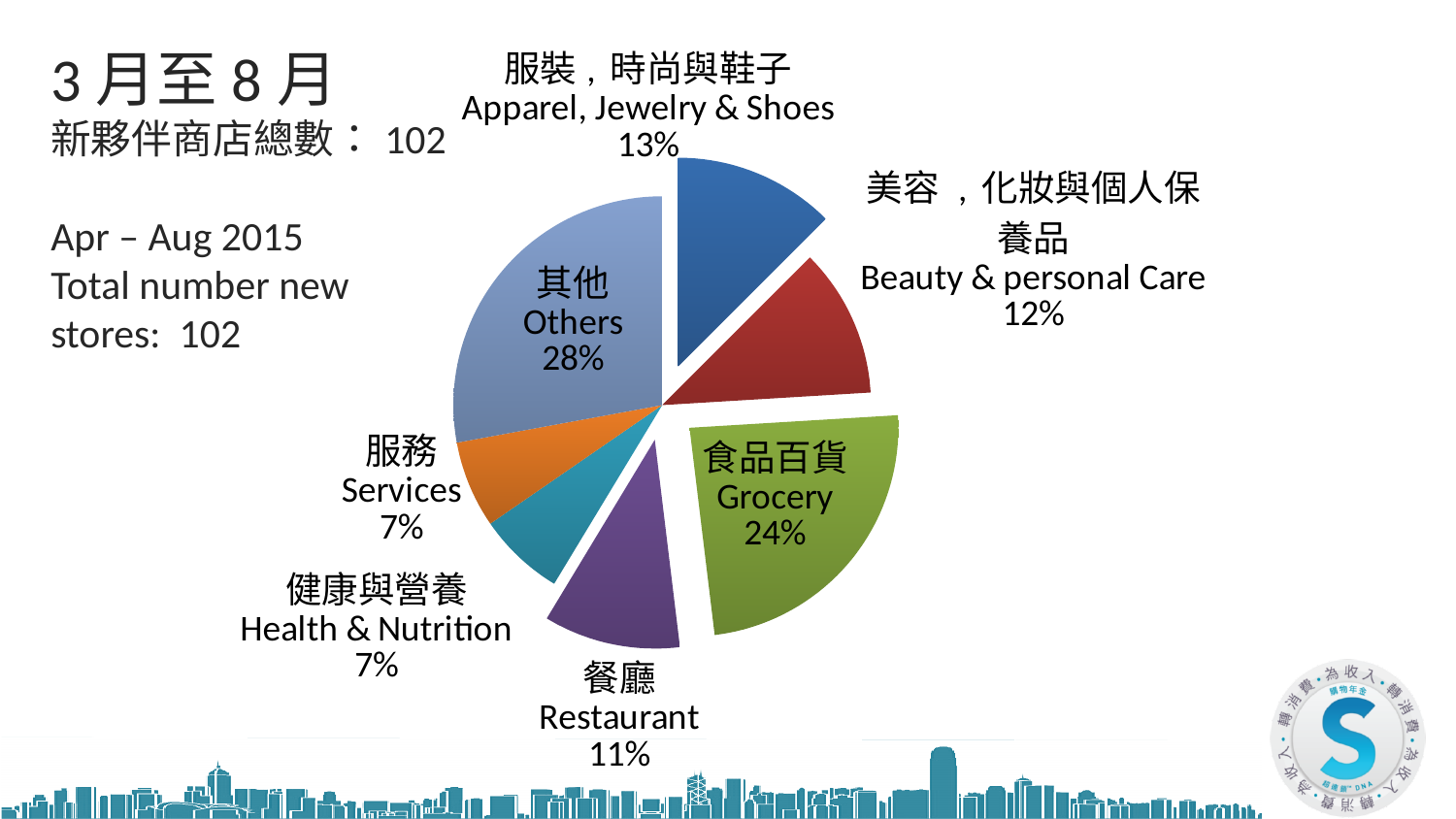
Which two categories share the smallest slice of the pie? Health & Nutrition and Services What kind of chart is shown on the slide? Pie chart What percentage is shown for Beauty & personal Care? 12% What is the combined percentage of Health & Nutrition and Services? 14% What percentage is shown for Restaurant? 11% What share of the pie does Grocery represent? 24% What percentage is shown for Apparel, Jewelry & Shoes? 13% How many categories are shown in the pie chart? 7 Which is larger, the Grocery slice or the Restaurant slice? Grocery What is the total number of new stores stated on the slide? 102 What is the difference in percentage points between Others and Grocery? 4 Which category has the largest slice of the pie? Others